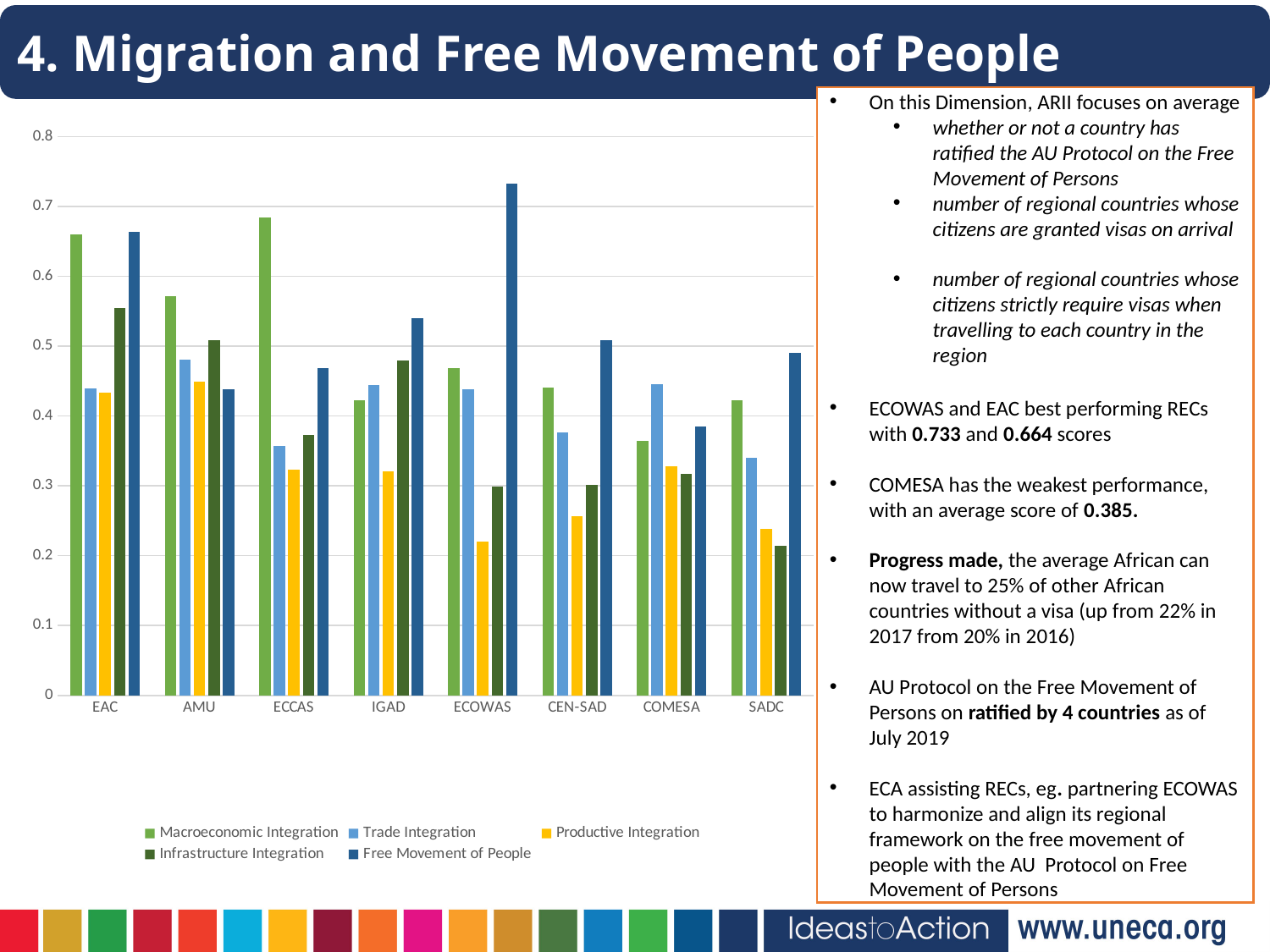
Which category has the highest Free Movement of People value? ECOWAS Is the Productive Integration value for ECOWAS greater or less than 0.3? less Which category has the highest Infrastructure Integration value? EAC Which is larger: the Free Movement of People value for EAC or for AMU? EAC Which category has the lowest Free Movement of People value? COMESA How many regional economic communities (categories) are shown on the x axis of the chart? 8 What type of chart is shown on the slide? bar chart Which category has the highest Trade Integration value? AMU Which series is shown in yellow in the chart legend? Productive Integration Which category has the lowest Infrastructure Integration value? SADC How many series does the chart legend list? 5 Is the Free Movement of People value for ECOWAS greater or less than 0.7? greater